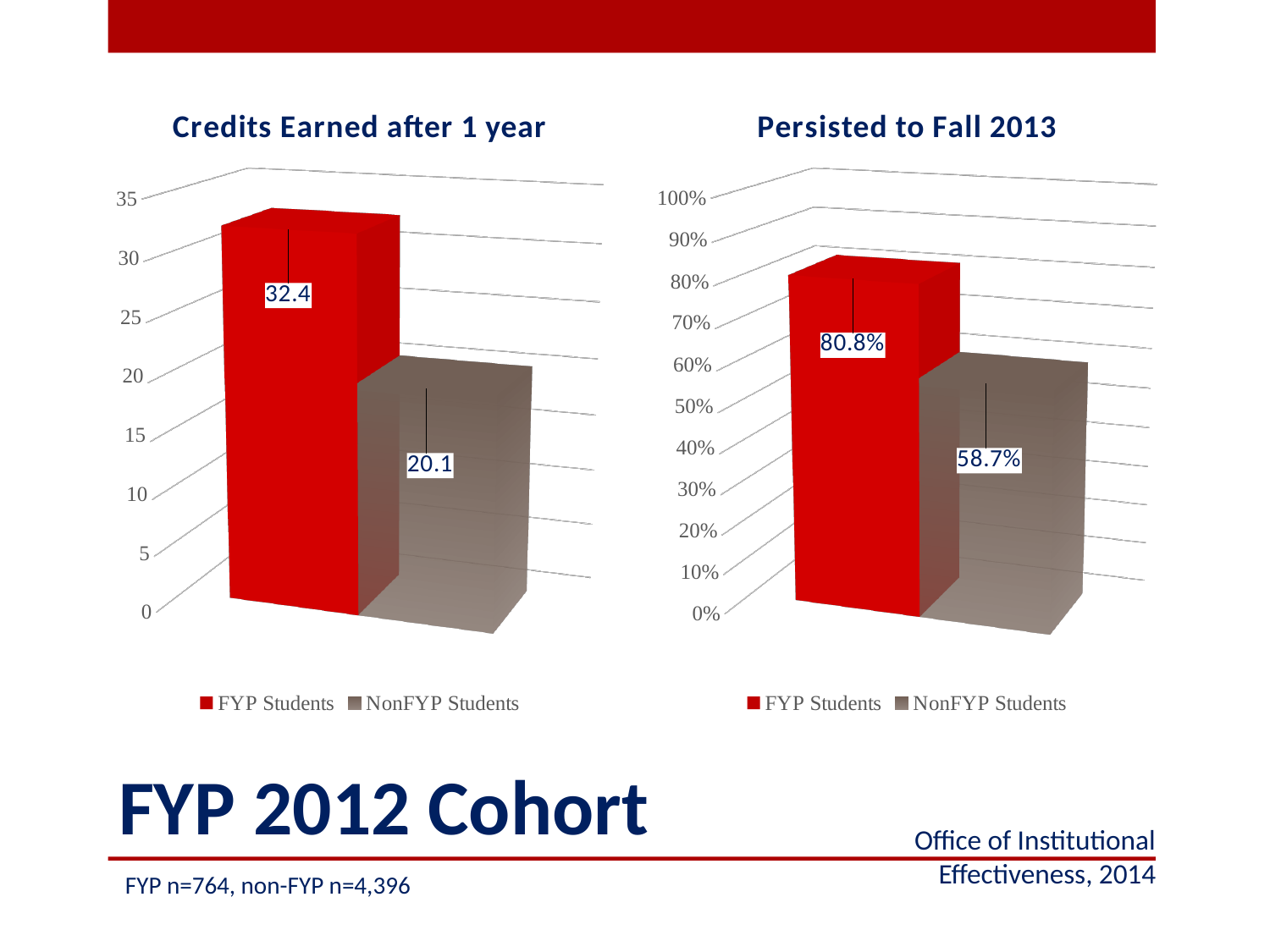
What colour are the FYP Students bars in both charts? Red In the 'Credits Earned after 1 year' chart, what is the difference between the FYP Students and NonFYP Students values? 12.3 In the 'Credits Earned after 1 year' chart, what is the value for NonFYP Students? 20.1 In the 'Credits Earned after 1 year' chart, which series has the lowest value? NonFYP Students In the 'Credits Earned after 1 year' chart, what is the value for FYP Students? 32.4 In the 'Persisted to Fall 2013' chart, is the value for NonFYP Students greater or less than 50%? greater In the 'Persisted to Fall 2013' chart, what is the difference between the FYP Students and NonFYP Students values? 22.1% How many series does the legend of the 'Credits Earned after 1 year' chart list? 2 In the 'Persisted to Fall 2013' chart, what is the value for FYP Students? 80.8% In the 'Persisted to Fall 2013' chart, what is the value for NonFYP Students? 58.7% In the 'Persisted to Fall 2013' chart, which series has the higher value? FYP Students What kind of chart is the 'Persisted to Fall 2013' chart? Bar chart